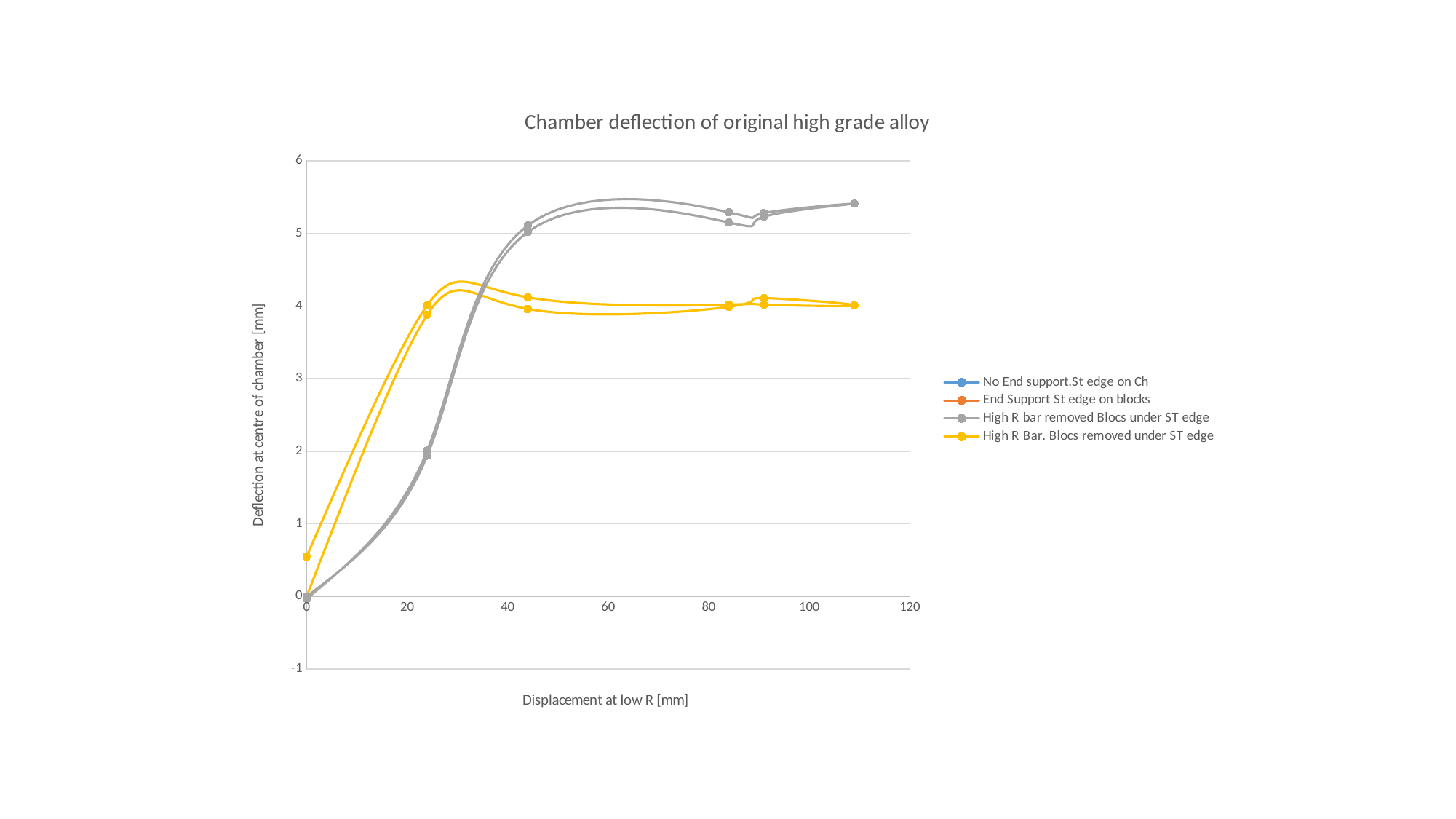
What type of chart is shown on the slide? line chart Does the deflection of the 'High R bar removed Blocs under ST edge' series rise or fall between displacements of 0 mm and about 44 mm? rise Is the deflection of the 'High R bar removed Blocs under ST edge' series at a displacement of about 109 mm greater or less than 5? greater What is the label of the horizontal axis? Displacement at low R [mm] How many series does the legend list? 4 At a displacement of about 24 mm, which series shows the higher deflection: 'High R bar removed Blocs under ST edge' or 'High R Bar. Blocs removed under ST edge'? High R Bar. Blocs removed under ST edge Is the deflection of the 'High R Bar. Blocs removed under ST edge' series at a displacement of about 109 mm greater or less than 5? less Is the deflection of the 'High R Bar. Blocs removed under ST edge' series at a displacement of 0 mm greater or less than 1? less At a displacement of about 109 mm, which series shows the higher deflection: 'High R bar removed Blocs under ST edge' or 'High R Bar. Blocs removed under ST edge'? High R bar removed Blocs under ST edge What is the title of the chart? Chamber deflection of original high grade alloy What is the highest value shown on the vertical axis? 6